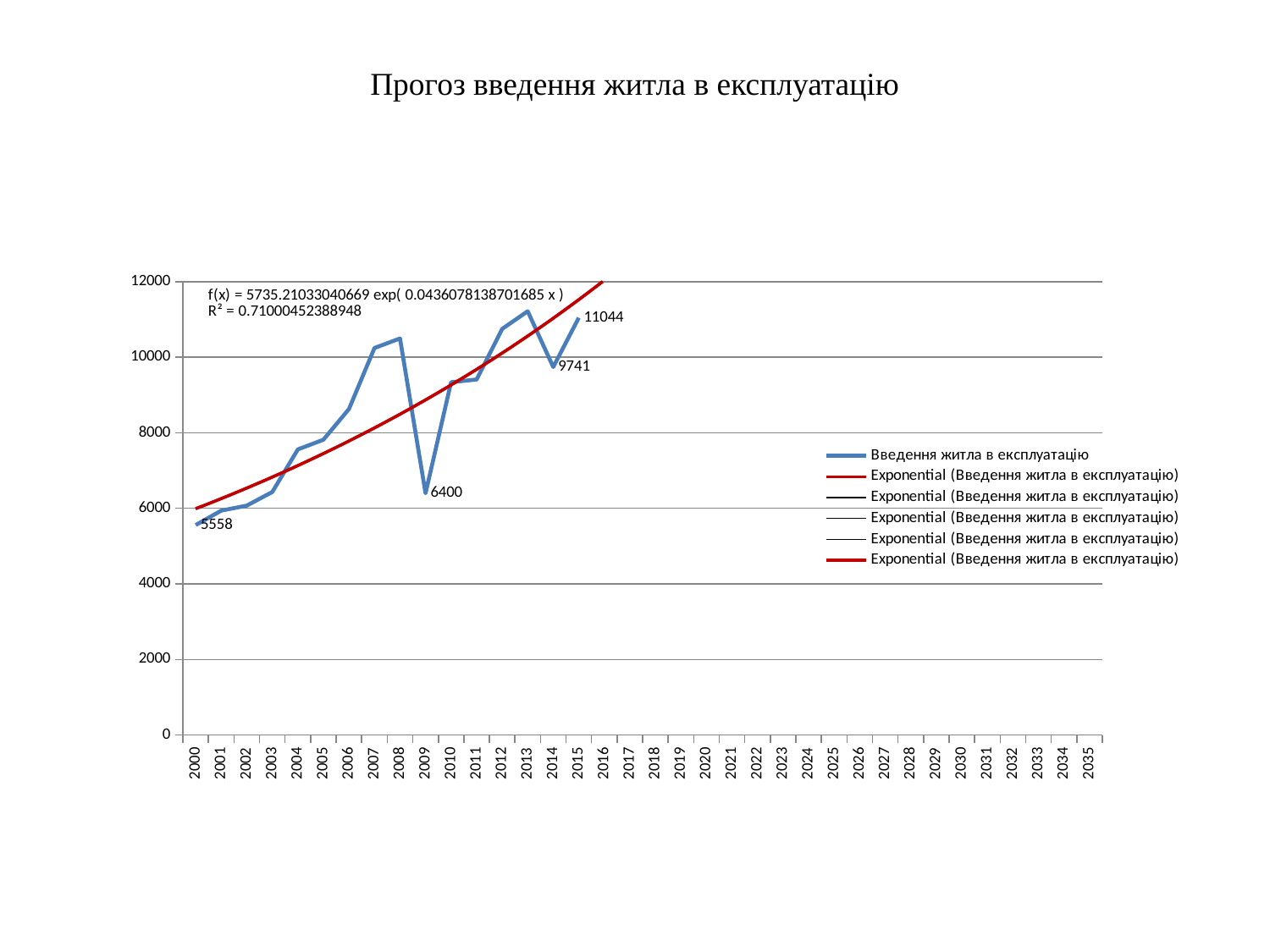
Does the blue series generally rise or fall from 2000 to 2015? rise What is the difference between the values for 2015 and 2014? 1303 Which year has the larger value, 2014 or 2015? 2015 What kind of chart is shown on the slide? line chart What is the value for 2014 on the chart? 9741 Is the value for 2013 greater or less than 10000? greater What is the value for 2009 on the chart? 6400 What R² value is printed on the chart? 0.71000452388948 What is the value for 2015 on the chart? 11044 Which year has the lowest value on the chart? 2000 What is the value for 2000 on the chart? 5558 Is the value for 2003 greater or less than 8000? less